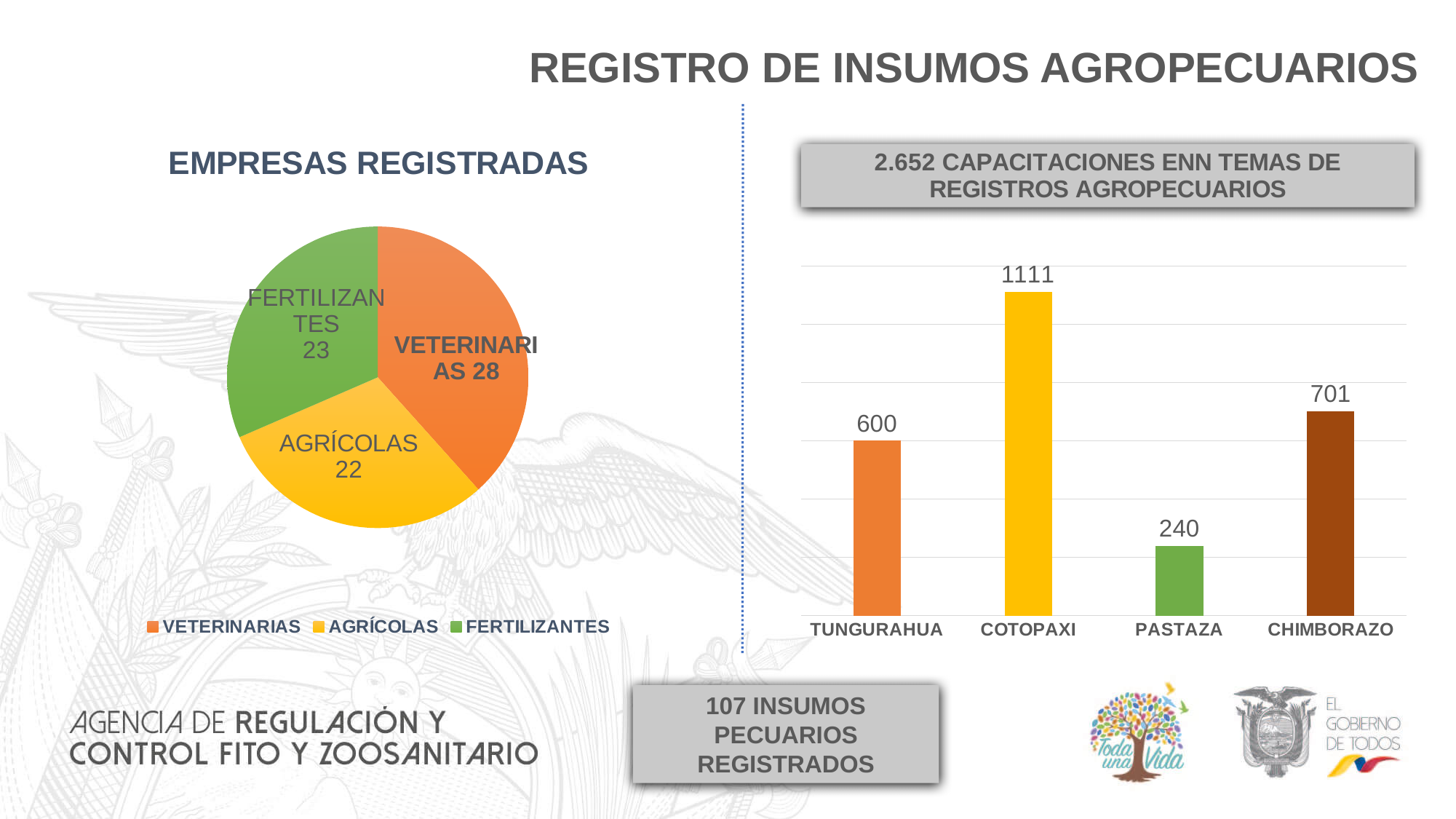
In the EMPRESAS REGISTRADAS pie chart, which category has the largest slice? VETERINARIAS In the bar chart on the right (CAPACITACIONES), what is the difference between COTOPAXI and TUNGURAHUA? 511 In the bar chart on the right (CAPACITACIONES), which is larger, TUNGURAHUA or CHIMBORAZO? CHIMBORAZO How many provinces are shown in the bar chart on the right (CAPACITACIONES)? 4 In the bar chart on the right (CAPACITACIONES), what is the value for COTOPAXI? 1111 In the EMPRESAS REGISTRADAS pie chart, how many categories does the legend list? 3 In the bar chart on the right (CAPACITACIONES), which province has the lowest value? PASTAZA In the EMPRESAS REGISTRADAS pie chart, what is the difference between VETERINARIAS and FERTILIZANTES? 5 In the bar chart on the right (CAPACITACIONES), what is the value for PASTAZA? 240 In the EMPRESAS REGISTRADAS pie chart, what is the value for AGRÍCOLAS? 22 In the EMPRESAS REGISTRADAS pie chart, what is the value for VETERINARIAS? 28 What kind of chart is the EMPRESAS REGISTRADAS chart? pie chart